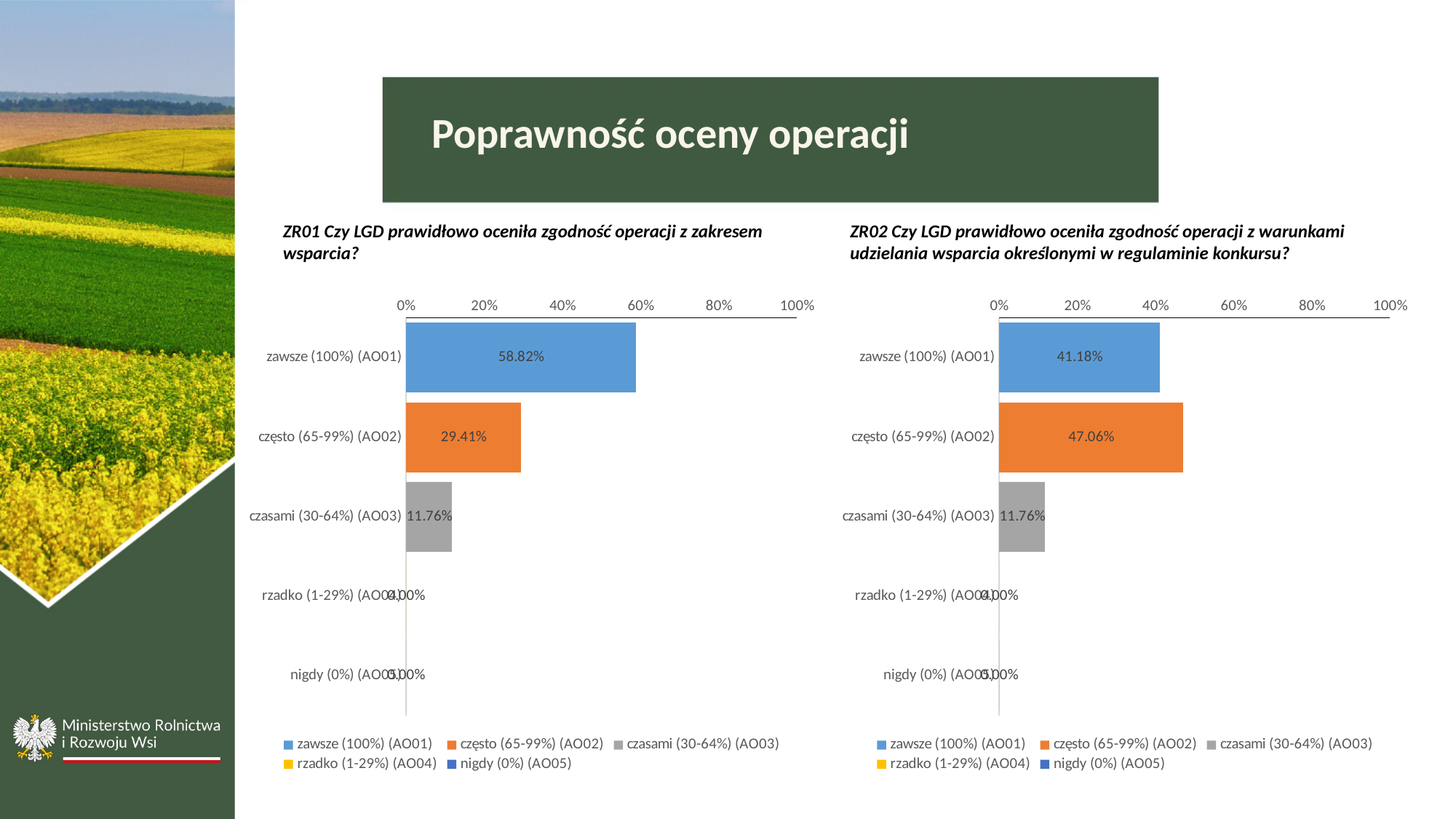
Which is larger: the value for zawsze (100%) (AO01) in the ZR01 chart or in the ZR02 chart? ZR01 chart In the ZR01 chart (left), what is the value for zawsze (100%) (AO01)? 58.82% What type of chart is the ZR01 chart (left)? bar chart In the ZR02 chart (right), what is the value for często (65-99%) (AO02)? 47.06% In the ZR01 chart (left), what is the difference between the values for zawsze (100%) (AO01) and często (65-99%) (AO02)? 29.41% In the ZR02 chart (right), what is the difference between the values for często (65-99%) (AO02) and zawsze (100%) (AO01)? 5.88% In the ZR02 chart (right), what is the value for zawsze (100%) (AO01)? 41.18% How many entries does the legend of the ZR02 chart (right) list? 5 In the ZR02 chart (right), which category has the highest value? często (65-99%) (AO02) In the ZR01 chart (left), what is the value for czasami (30-64%) (AO03)? 11.76% In the ZR01 chart (left), which category has the highest value? zawsze (100%) (AO01) How many categories are shown in the ZR01 chart (left)? 5